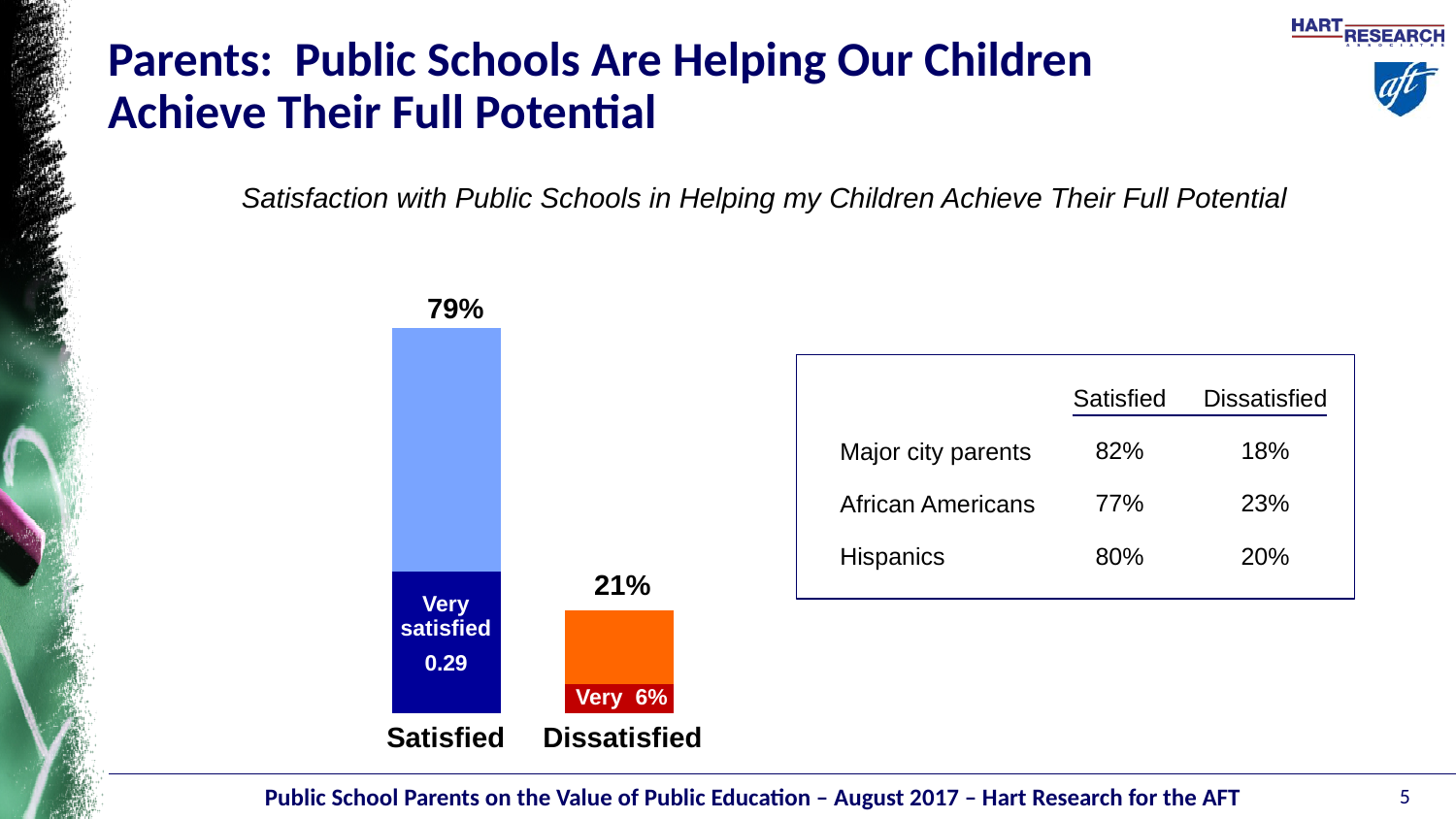
What is the difference between the Satisfied total (79%) and the Dissatisfied total (21%)? 58 percentage points What is the total value shown above the Satisfied bar? 79% Which category has the highest total value in the bar chart? Satisfied What value is printed in the Very satisfied segment of the Satisfied bar? 0.29 What kind of chart is shown on the slide? bar chart How many categories are shown on the x axis of the bar chart? 2 Which category has the lowest total value in the bar chart? Dissatisfied What colour is the Very satisfied segment of the Satisfied bar? dark blue What is the italic subtitle printed above the chart? Satisfaction with Public Schools in Helping my Children Achieve Their Full Potential What is the total value shown above the Dissatisfied bar? 21% What value is printed in the Very segment of the Dissatisfied bar? 6% Which category has the taller bar, Satisfied or Dissatisfied? Satisfied